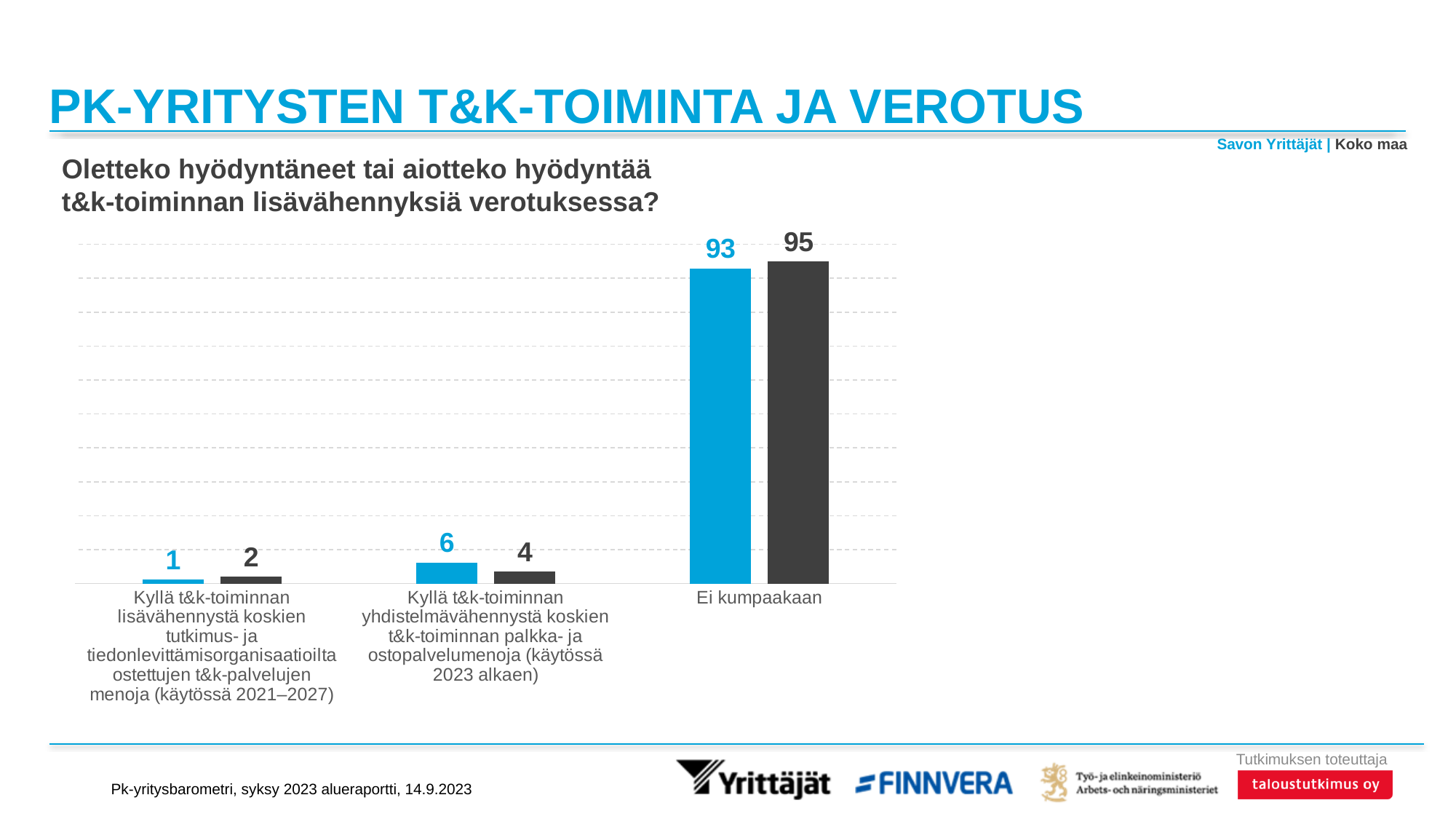
What is the value for Savon Yrittäjät for the category "Kyllä t&k-toiminnan yhdistelmävähennystä koskien t&k-toiminnan palkka- ja ostopalvelumenoja (käytössä 2023 alkaen)"? 6 What is the value for Koko maa in the "Ei kumpaakaan" category? 95 What kind of chart is shown on the slide? Bar chart Which category has the lowest value for Koko maa? Kyllä t&k-toiminnan lisävähennystä koskien tutkimus- ja tiedonlevittämisorganisaatioilta ostettujen t&k-palvelujen menoja (käytössä 2021–2027) Which colour represents Savon Yrittäjät in the chart? Blue What is the difference between the Koko maa and Savon Yrittäjät values in the "Ei kumpaakaan" category? 2 How many series does the chart show? 2 How many categories are shown on the x axis of the chart? 3 Which category has the highest value for Savon Yrittäjät? Ei kumpaakaan What is the value for Koko maa for the category "Kyllä t&k-toiminnan lisävähennystä koskien tutkimus- ja tiedonlevittämisorganisaatioilta ostettujen t&k-palvelujen menoja (käytössä 2021–2027)"? 2 What is the value for Savon Yrittäjät in the "Ei kumpaakaan" category? 93 In the "Kyllä t&k-toiminnan yhdistelmävähennystä" category, which is larger: Savon Yrittäjät or Koko maa? Savon Yrittäjät